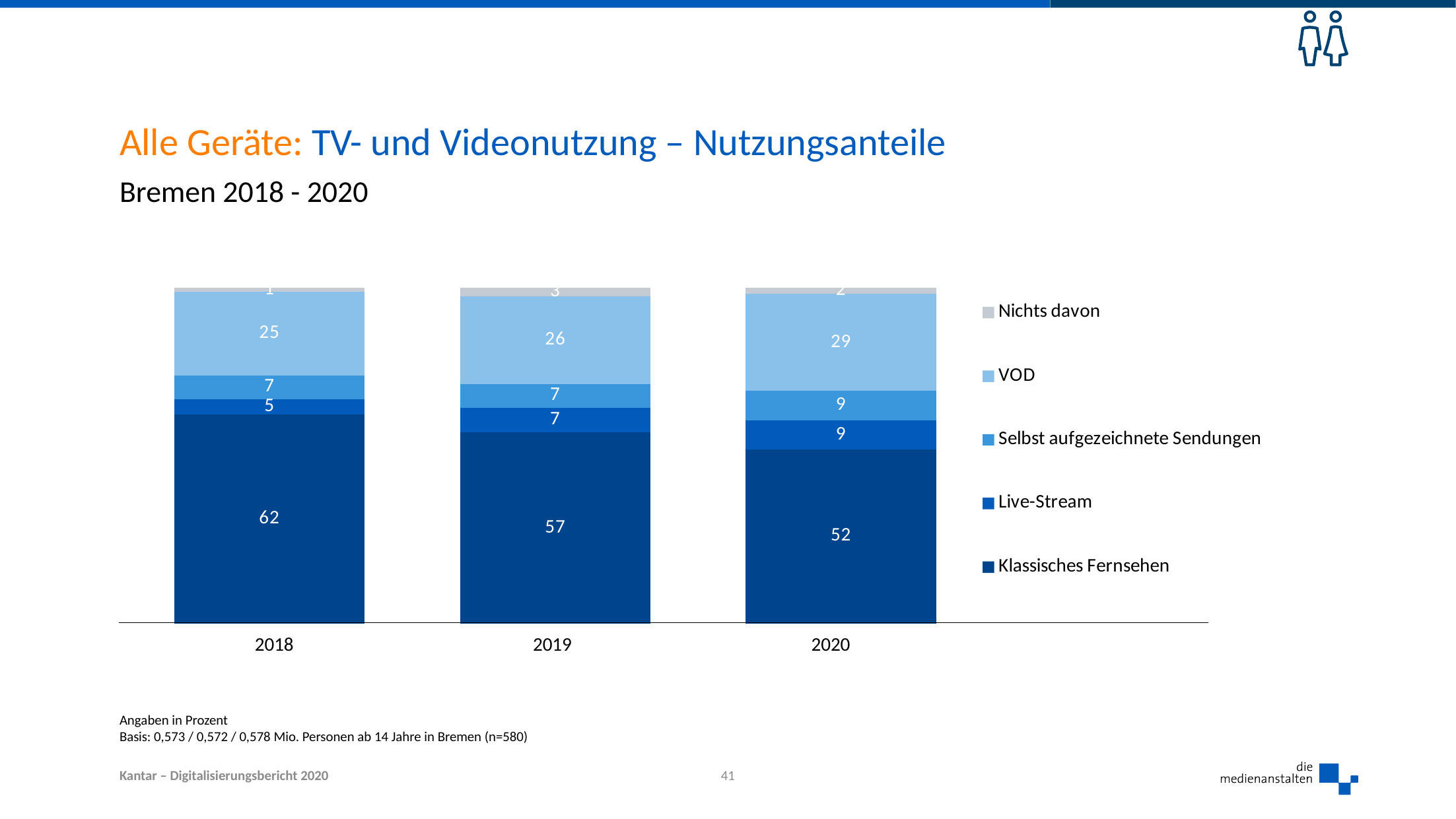
What is the value for Klassisches Fernsehen in 2018? 62 In which year is the value for Klassisches Fernsehen the lowest? 2020 What kind of chart is shown on the slide? stacked bar chart What is the value for VOD in 2020? 29 How many years are shown on the x axis? 3 How does the value for Klassisches Fernsehen change from 2018 to 2020? it falls What is the value for Selbst aufgezeichnete Sendungen in 2020? 9 Which is larger, the Live-Stream value in 2018 or in 2020? 2020 In which year is the value for VOD the highest? 2020 How many series does the legend list? 5 What is the difference between the Klassisches Fernsehen values for 2018 and 2020? 10 What is the value for Live-Stream in 2019? 7